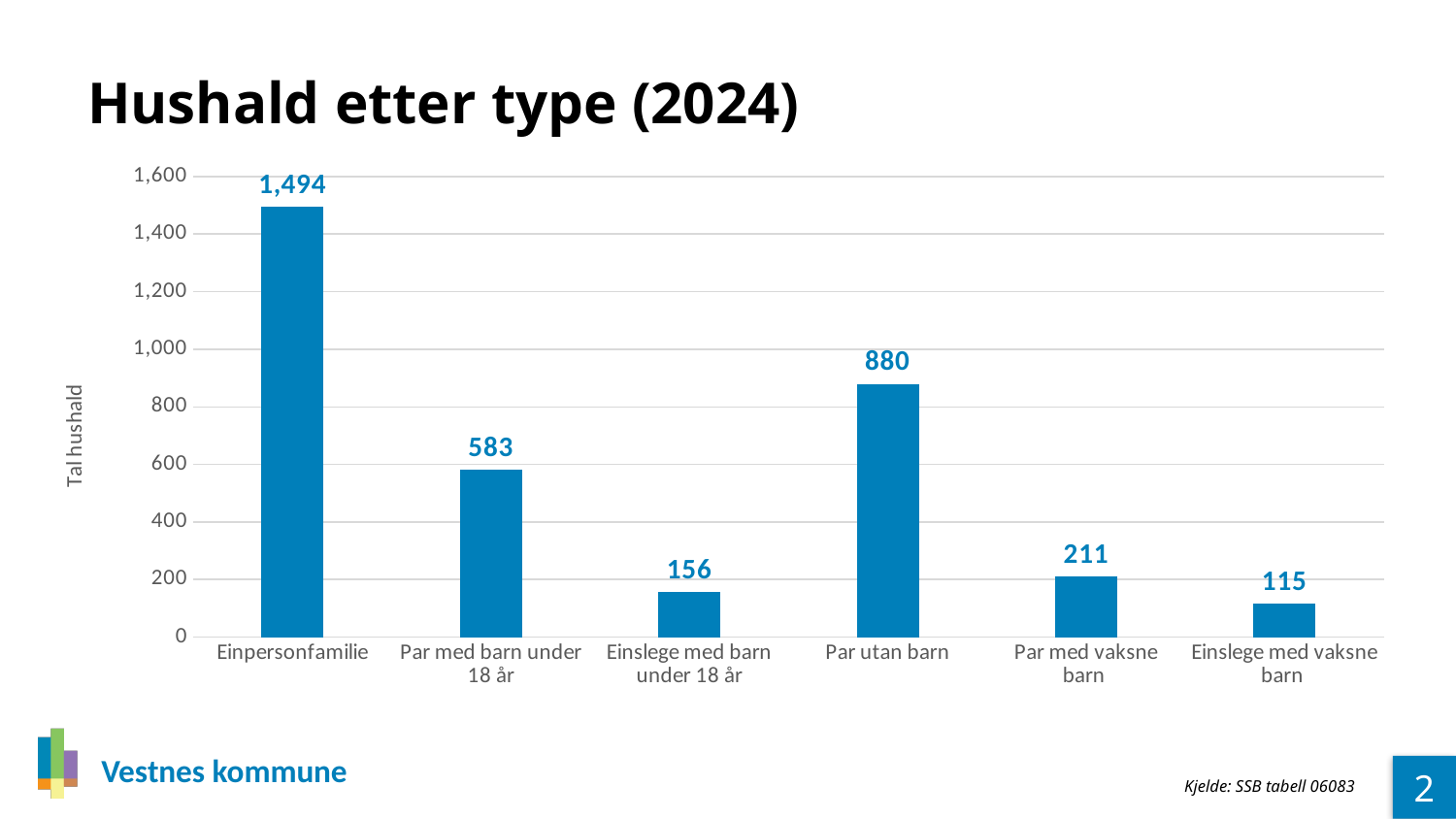
What kind of chart is shown on the slide? bar chart Which household type has the lowest value? Einslege med vaksne barn Which is larger, Par med vaksne barn or Einslege med barn under 18 år? Par med vaksne barn What is the title of the chart? Hushald etter type (2024) What is the value for Einpersonfamilie? 1,494 Which household type has the highest value? Einpersonfamilie How many household types are shown on the chart? 6 What is the value for Einslege med vaksne barn? 115 What is the value for Einslege med barn under 18 år? 156 What is the value for Par utan barn? 880 What is the difference between Par utan barn and Par med barn under 18 år? 297 Is the value for Par med barn under 18 år greater or less than 600? less